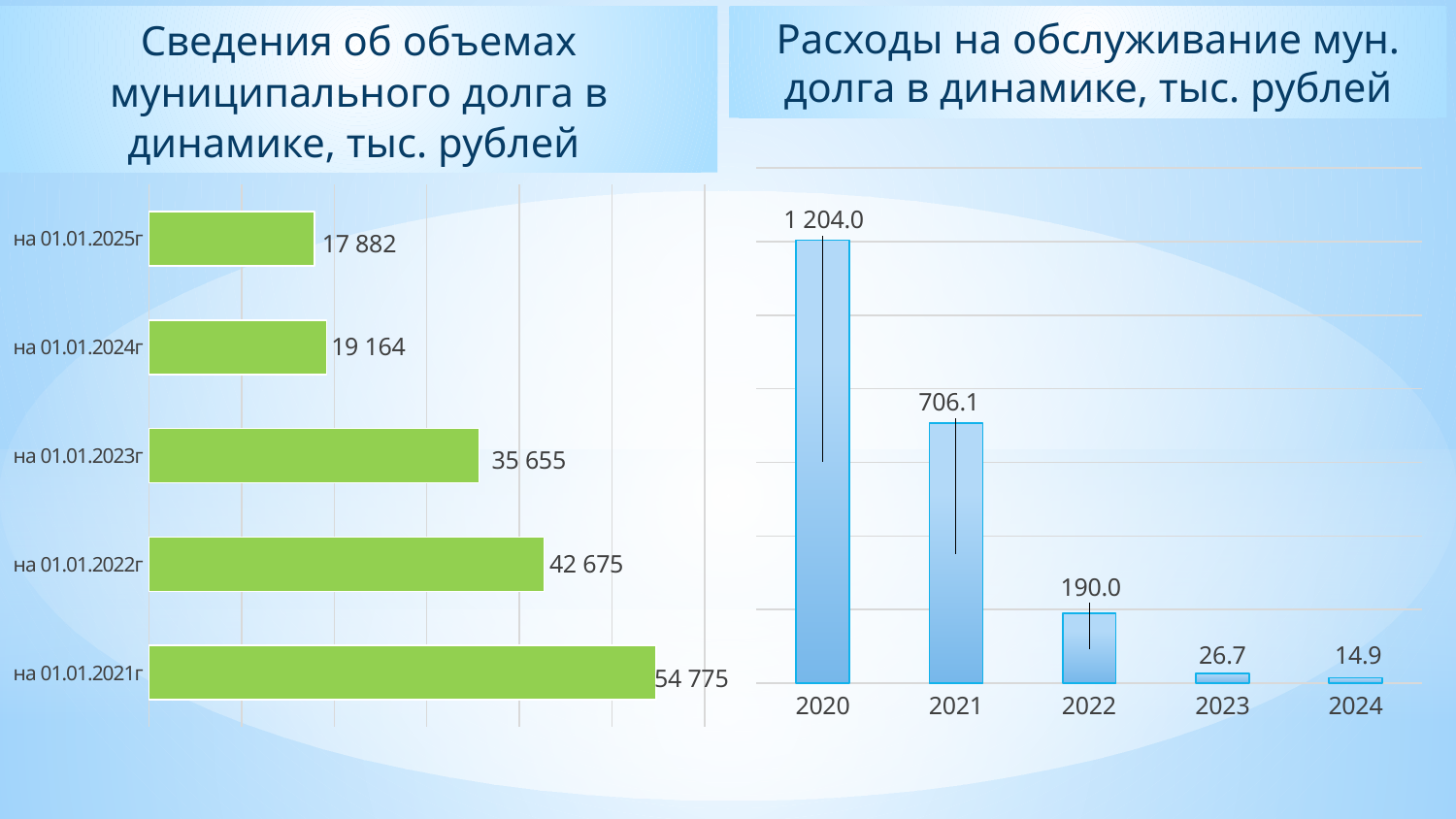
In the right chart (Расходы на обслуживание мун. долга), what is the value for 2021? 706.1 In the right chart (Расходы на обслуживание мун. долга), what is the difference between the values for 2020 and 2022? 1 014.0 In the right chart (Расходы на обслуживание мун. долга), which is larger, the value for 2022 or the value for 2023? 2022 What kind of chart is the left chart (Сведения об объемах муниципального долга)? Bar chart In the left chart (Сведения об объемах муниципального долга), which category has the lowest value? на 01.01.2025г In the right chart (Расходы на обслуживание мун. долга), do the values rise or fall from 2020 to 2024? Fall In the right chart (Расходы на обслуживание мун. долга), what is the value for 2024? 14.9 In the left chart (Сведения об объемах муниципального долга), which category has the highest value? на 01.01.2021г In the right chart (Расходы на обслуживание мун. долга), which year has the highest value? 2020 In the left chart (Сведения об объемах муниципального долга), what is the value for на 01.01.2023г? 35 655 In the left chart (Сведения об объемах муниципального долга), how many categories are shown? 5 In the left chart (Сведения об объемах муниципального долга), what is the difference between the values for на 01.01.2022г and на 01.01.2024г? 23 511